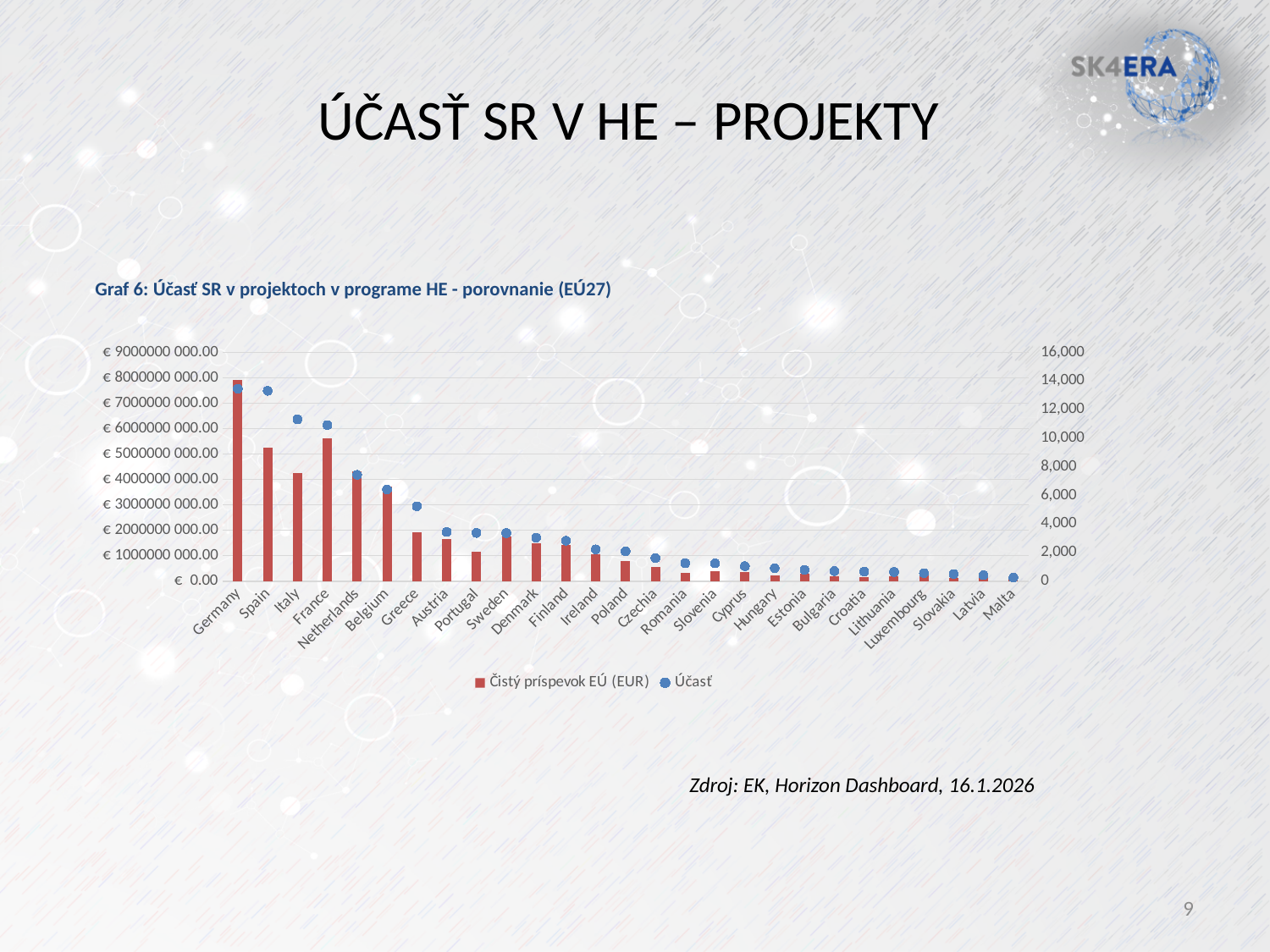
How many series does the legend list? 2 Which has the larger Čistý príspevok EÚ (EUR) bar, France or Italy? France Which has the larger Čistý príspevok EÚ (EUR) bar, Spain or Italy? Spain Which country has the lowest value for Čistý príspevok EÚ (EUR)? Malta Is the Čistý príspevok EÚ (EUR) bar for Slovakia greater or less than € 1000000 000.00? less What kind of chart is shown on the slide? bar chart (with a dot series on a secondary axis) Which country has the highest value for Čistý príspevok EÚ (EUR)? Germany How many countries are shown on the x axis of the chart? 27 Is the Účasť value for Italy greater or less than 10,000? greater Do the Čistý príspevok EÚ (EUR) bars generally rise or fall from left to right along the x axis? fall Which country has the lowest Účasť value? Malta Is the Čistý príspevok EÚ (EUR) bar for Germany greater or less than € 7000000 000.00? greater